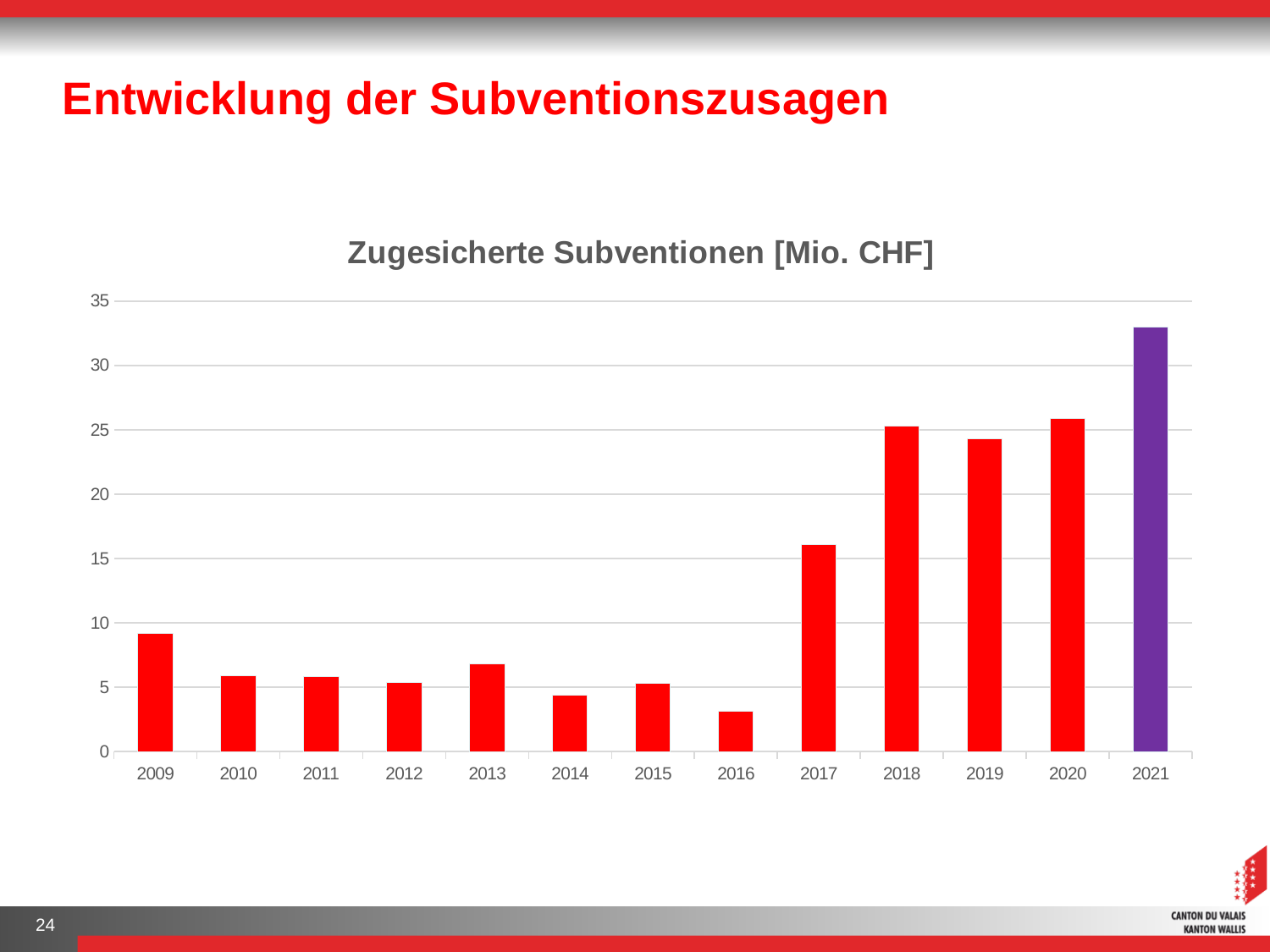
Is the value for 2016 greater or less than 5? less Which year has the lowest value in the chart? 2016 Is the value for 2009 greater or less than 10? less What kind of chart is shown on the slide? bar chart Which year has the highest value in the chart? 2021 Do the values rise or fall from 2016 to 2021? rise How many years are shown on the x axis of the chart? 13 What is the title of the chart? Zugesicherte Subventionen [Mio. CHF] Which bar in the chart is coloured differently from the others? 2021 Is the value for 2017 greater or less than 15? greater Which year has the larger value, 2017 or 2009? 2017